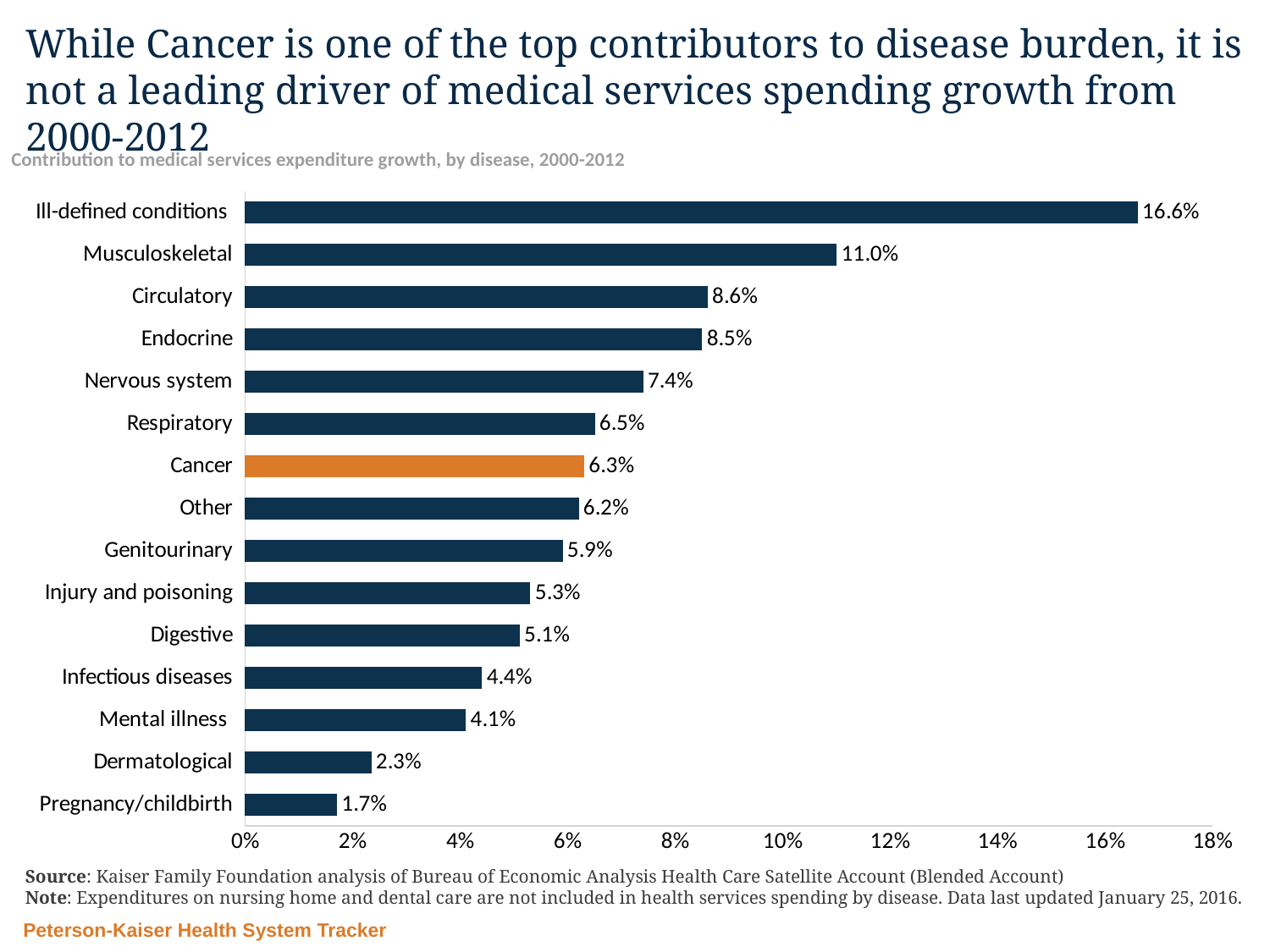
Which has a larger value, Nervous system or Digestive? Nervous system What is the difference between the values for Cancer and Mental illness? 2.2% How many disease categories are shown in the chart? 15 What is the contribution to medical services expenditure growth for Cancer? 6.3% What is the difference between the values for Ill-defined conditions and Musculoskeletal? 5.6% Which category has the lowest contribution to medical services expenditure growth? Pregnancy/childbirth What is the value shown for Musculoskeletal? 11.0% What is the value shown for Pregnancy/childbirth? 1.7% Is the value for Circulatory greater or less than 8%? greater Which category has the highest contribution to medical services expenditure growth? Ill-defined conditions What kind of chart is shown on the slide? Bar chart Which category's bar is highlighted in orange? Cancer